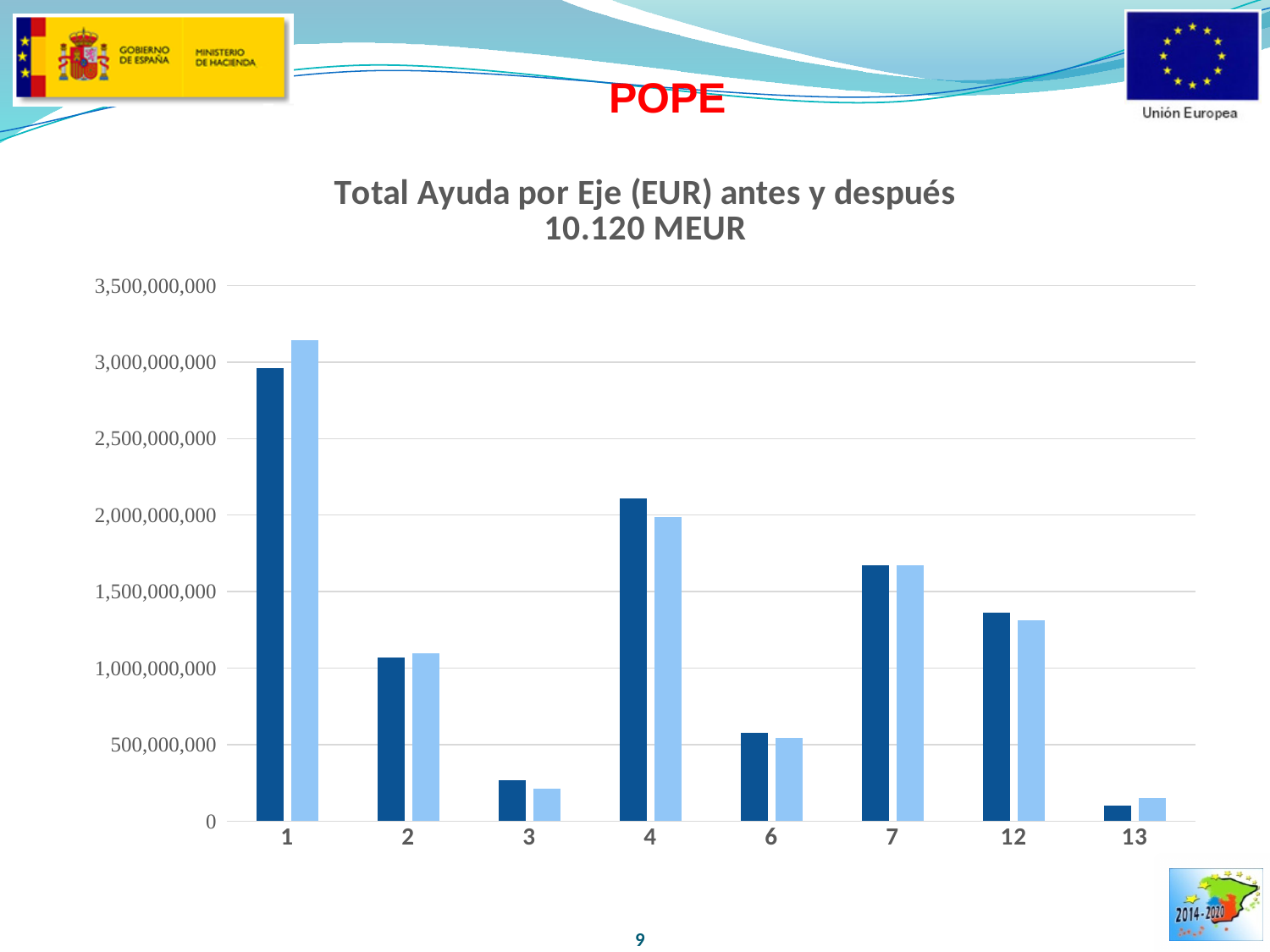
Is the dark blue bar for category 7 greater or less than 1,500,000,000? greater Is the dark blue bar for category 12 greater or less than 1,500,000,000? less Which category has the larger dark blue bar, 2 or 6? 2 How many categories are shown on the x axis of the chart? 8 Is the light blue bar for category 1 greater or less than 3,000,000,000? greater Which category has the highest bars in the chart? 1 Which category has the lowest bars in the chart? 13 What is the title of the chart? Total Ayuda por Eje (EUR) antes y después 10.120 MEUR What kind of chart is shown on the slide? bar chart Which category has the larger dark blue bar, 4 or 7? 4